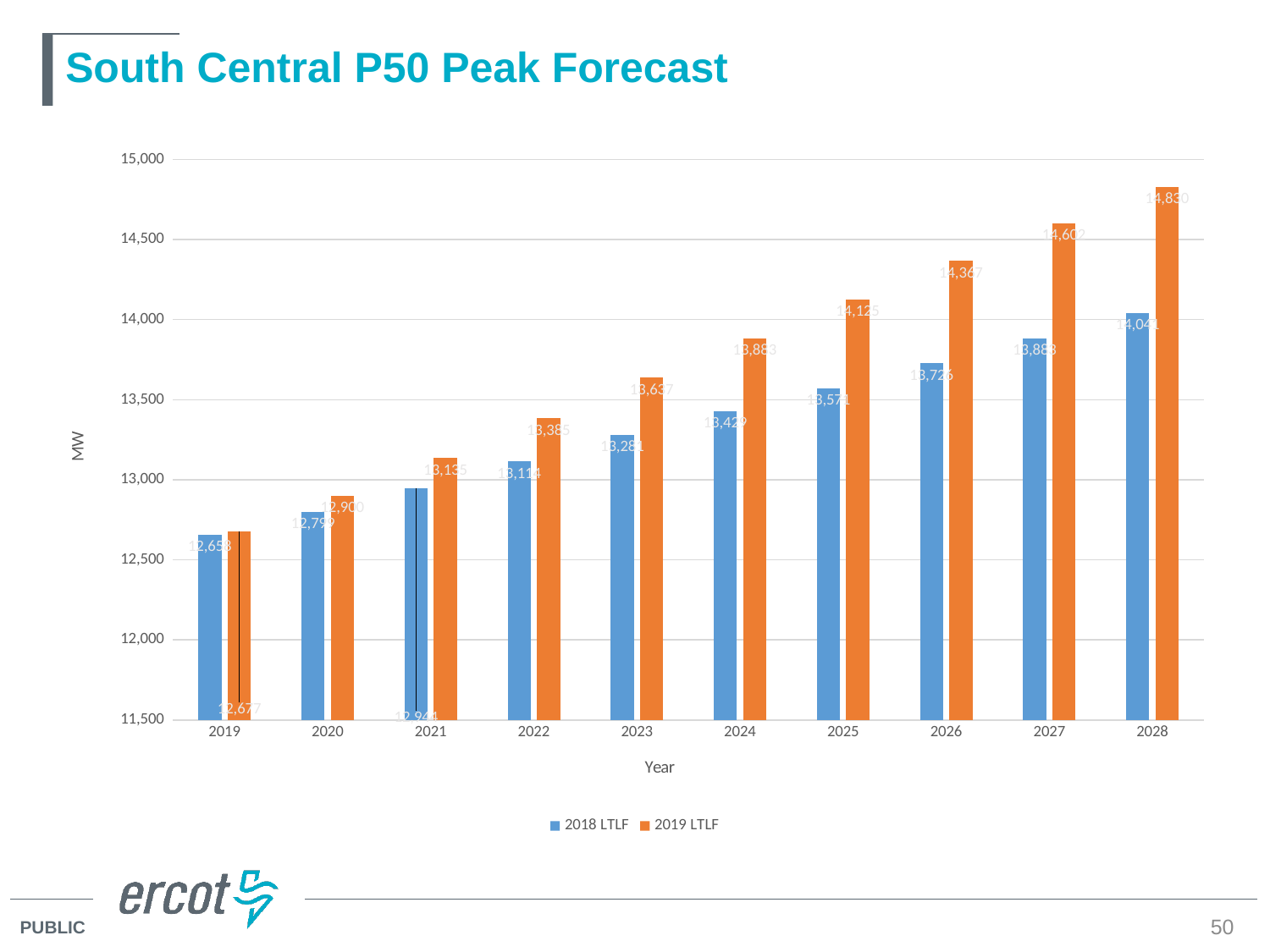
How many years are shown on the x axis? 10 What is the 2019 LTLF value for 2028? 14,830 What is the 2019 LTLF value for 2025? 14,125 Is the 2018 LTLF value for 2025 greater or less than 14,000? less For 2027, which series has the larger value, 2018 LTLF or 2019 LTLF? 2019 LTLF What is the difference between the 2019 LTLF and 2018 LTLF values for 2028? 789 Do the 2019 LTLF values rise or fall from 2019 to 2028? rise How many series does the legend list? 2 Which year has the lowest 2018 LTLF value? 2019 What kind of chart is shown on the slide? Bar chart Which year has the highest 2019 LTLF value? 2028 What is the 2018 LTLF value for 2028? 14,041